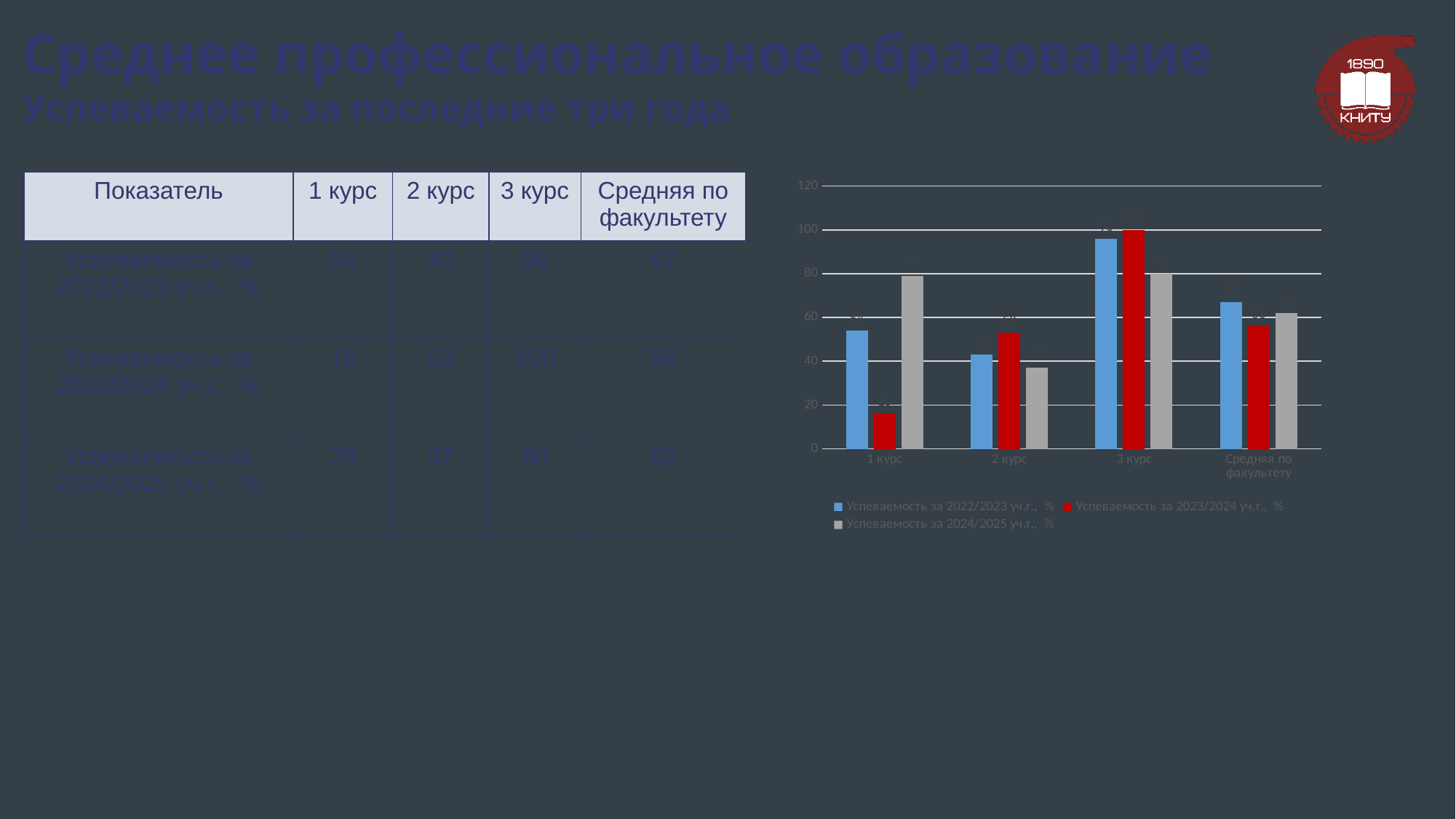
What colour are the bars for the series 'Успеваемость за 2023/2024 уч.г., %'? red How many series does the chart legend list? 3 Is the value for '1 курс' in the series 'Успеваемость за 2022/2023 уч.г., %' greater or less than 40? greater What kind of chart is shown on the slide? bar chart What is the value for '3 курс' in the series 'Успеваемость за 2023/2024 уч.г., %'? 100 What is the value for '3 курс' in the series 'Успеваемость за 2024/2025 уч.г., %'? 80 Is the value for '1 курс' in the series 'Успеваемость за 2023/2024 уч.г., %' greater or less than 20? less Do the values for the series 'Успеваемость за 2023/2024 уч.г., %' rise or fall from '1 курс' to '3 курс'? rise Which category has the highest value for the series 'Успеваемость за 2023/2024 уч.г., %'? 3 курс For '1 курс', which series has the larger value: 'Успеваемость за 2022/2023 уч.г., %' or 'Успеваемость за 2024/2025 уч.г., %'? Успеваемость за 2024/2025 уч.г., % Which category has the lowest value for the series 'Успеваемость за 2023/2024 уч.г., %'? 1 курс How many categories are shown on the x axis of the chart? 4